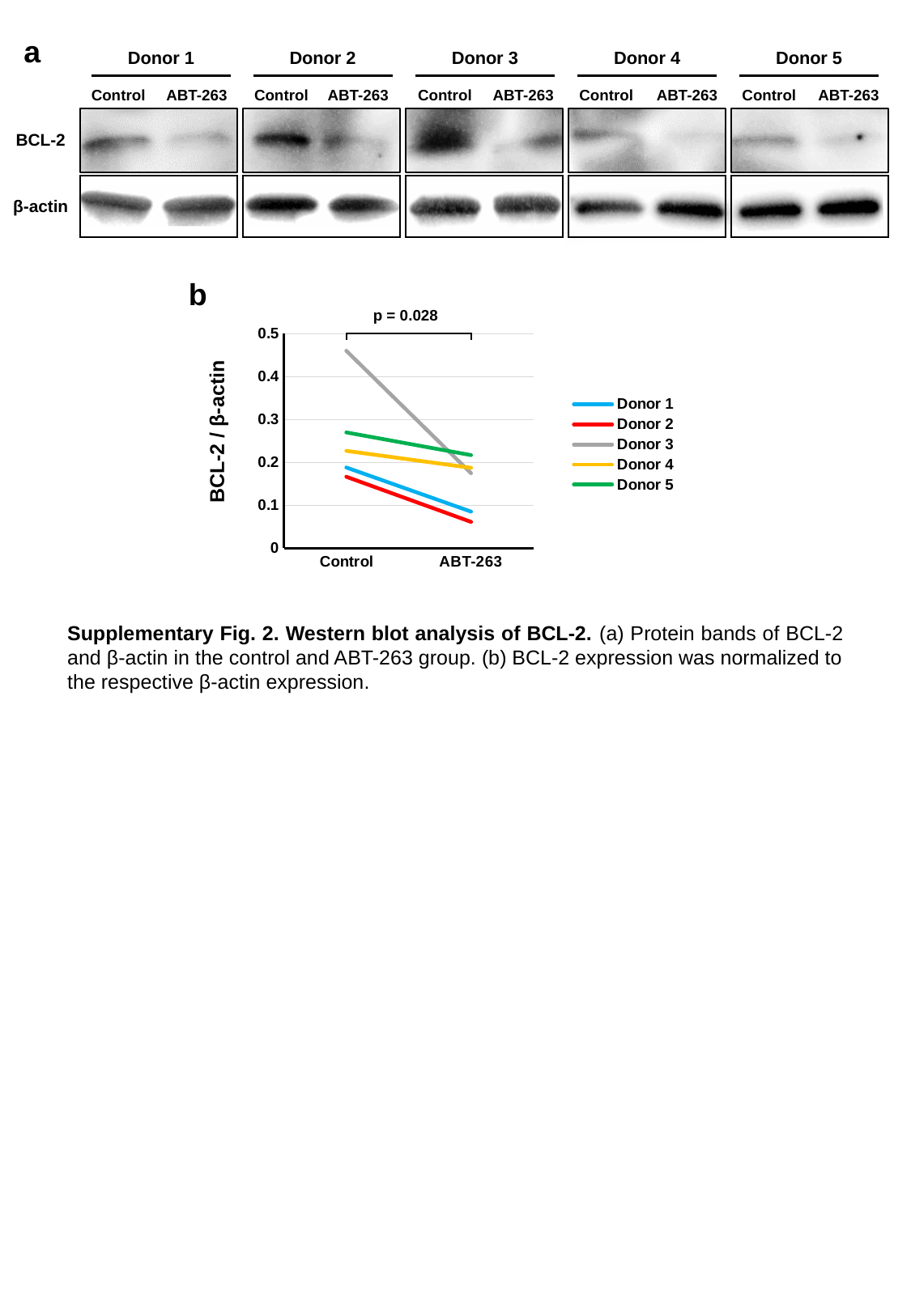
In the chart in panel b, do the values for Donor 3 rise or fall from Control to ABT-263? fall What kind of chart is shown in panel b? line chart In the chart in panel b, which donor has the lowest BCL-2 / β-actin value at ABT-263? Donor 2 In the chart in panel b, is the value for Donor 2 at ABT-263 greater or less than 0.1? less How many categories are on the x axis of the chart in panel b? 2 How many series does the legend of the chart in panel b list? 5 In the chart in panel b, is the value for Donor 5 at Control greater or less than 0.2? greater In the chart in panel b, is the value for Donor 3 at Control greater or less than 0.4? greater What p value is shown above the chart in panel b? p = 0.028 What is the y-axis label of the chart in panel b? BCL-2 / β-actin In the chart in panel b, which donor has the highest BCL-2 / β-actin value at Control? Donor 3 In the chart in panel b, which is larger at Control: the value for Donor 3 or the value for Donor 1? Donor 3